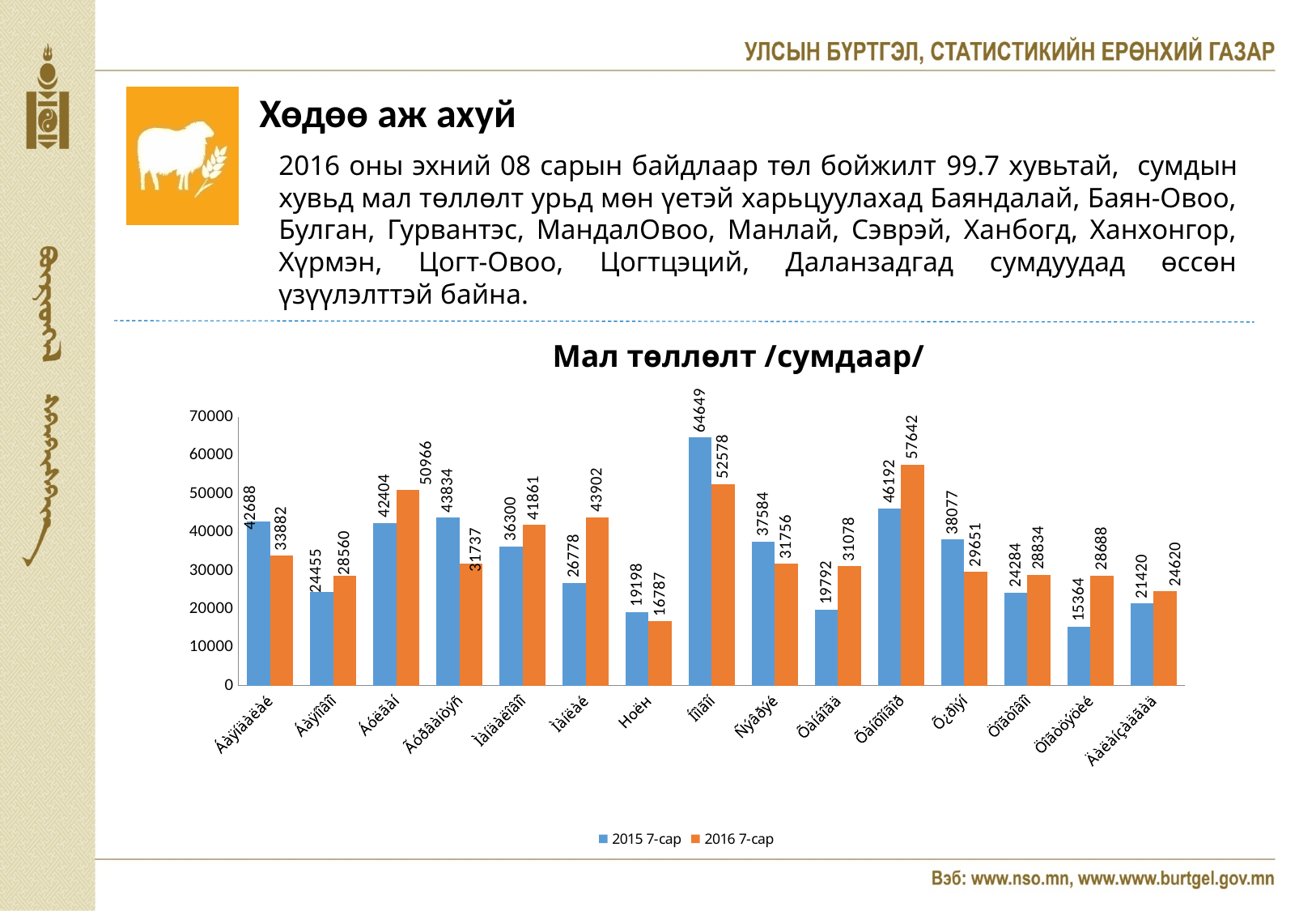
Is the 2016 7-сар value for Ноён greater or less than 20000? less What kind of chart is shown on the slide? bar chart What is the difference between the 2015 7-сар and 2016 7-сар values for Ноён? 2411 What is the title of the chart? Мал төллөлт /сумдаар/ For Ноён, which series has the larger value, 2015 7-сар or 2016 7-сар? 2015 7-сар What is the value for Ноён in the 2016 7-сар series? 16787 What is the highest value shown in the 2015 7-сар series? 64649 How many series does the chart's legend list? 2 What is the value for Ноён in the 2015 7-сар series? 19198 What is the highest value shown in the 2016 7-сар series? 57642 What are the two series named in the legend? 2015 7-сар and 2016 7-сар How many categories are plotted along the x axis of the chart? 15